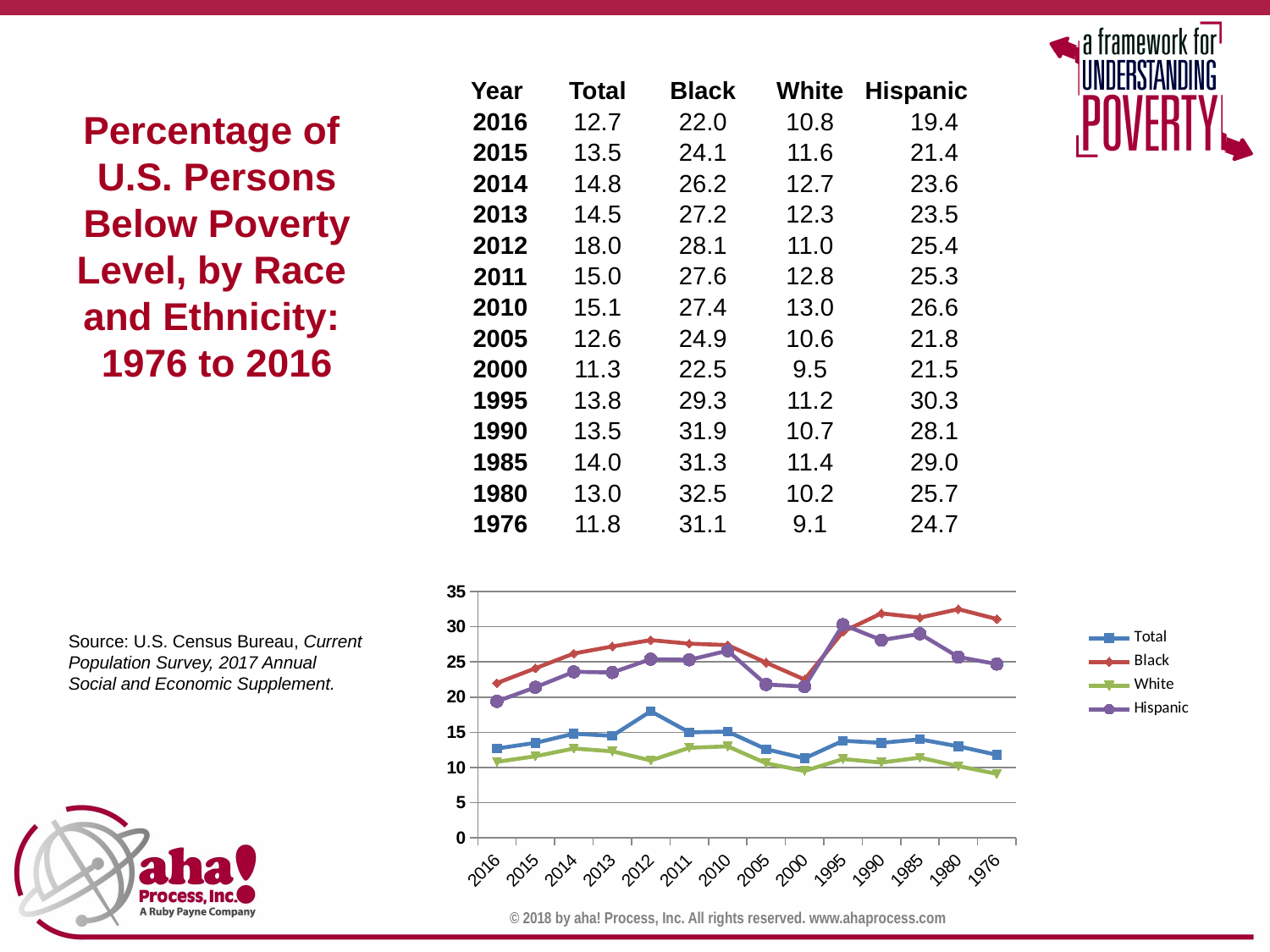
How many series does the chart's legend list? 4 What kind of chart is shown on the slide? line chart How many years are plotted along the x axis of the chart? 14 What is the Black poverty rate for 2016? 22.0 What is the Hispanic poverty rate for 1995? 30.3 Which series is shown in green in the chart's legend? White What is the Total poverty rate for 2012? 18.0 Which is larger in 1995, the Black rate or the Hispanic rate? Hispanic What is the difference between the Black and White poverty rates in 1976? 22.0 In which year is the Black poverty rate highest? 1980 Is the Hispanic value for 2016 greater or less than 20? less In which year is the White poverty rate lowest? 1976